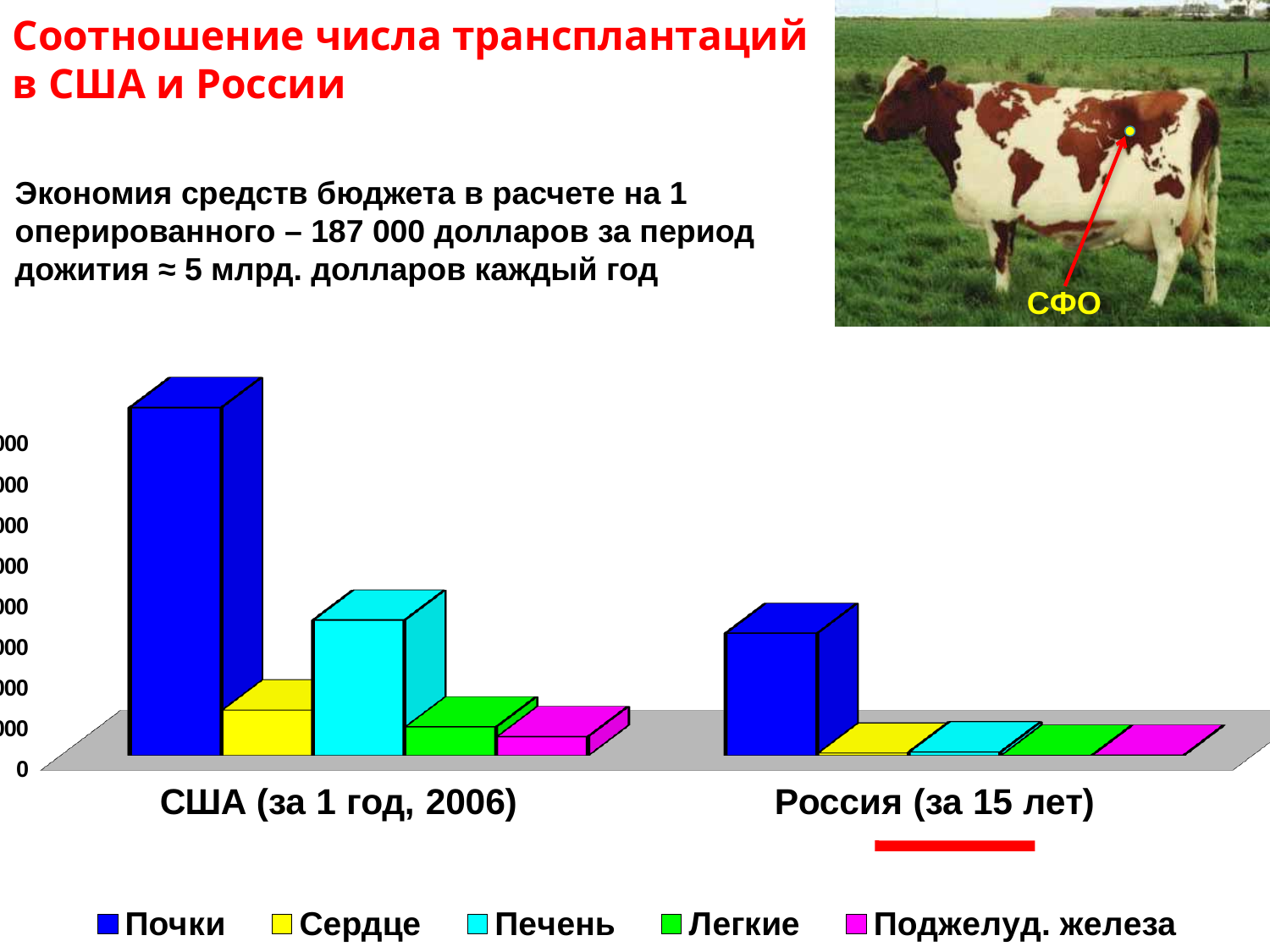
Which is larger: the Печень bar for США (за 1 год, 2006) or the Печень bar for Россия (за 15 лет)? США (за 1 год, 2006) How many series does the chart legend list? 5 Which is larger in the США (за 1 год, 2006) category: Печень or Легкие? Печень What is the label of the second category on the x axis? Россия (за 15 лет) Which series in the chart legend is shown in yellow? Сердце Which series has the highest bar in the США (за 1 год, 2006) category? Почки Which is larger in the США (за 1 год, 2006) category: Печень or Сердце? Печень Which series has the highest bar in the Россия (за 15 лет) category? Почки How many categories are shown on the x axis of the chart? 2 What kind of chart is shown on the slide? bar chart